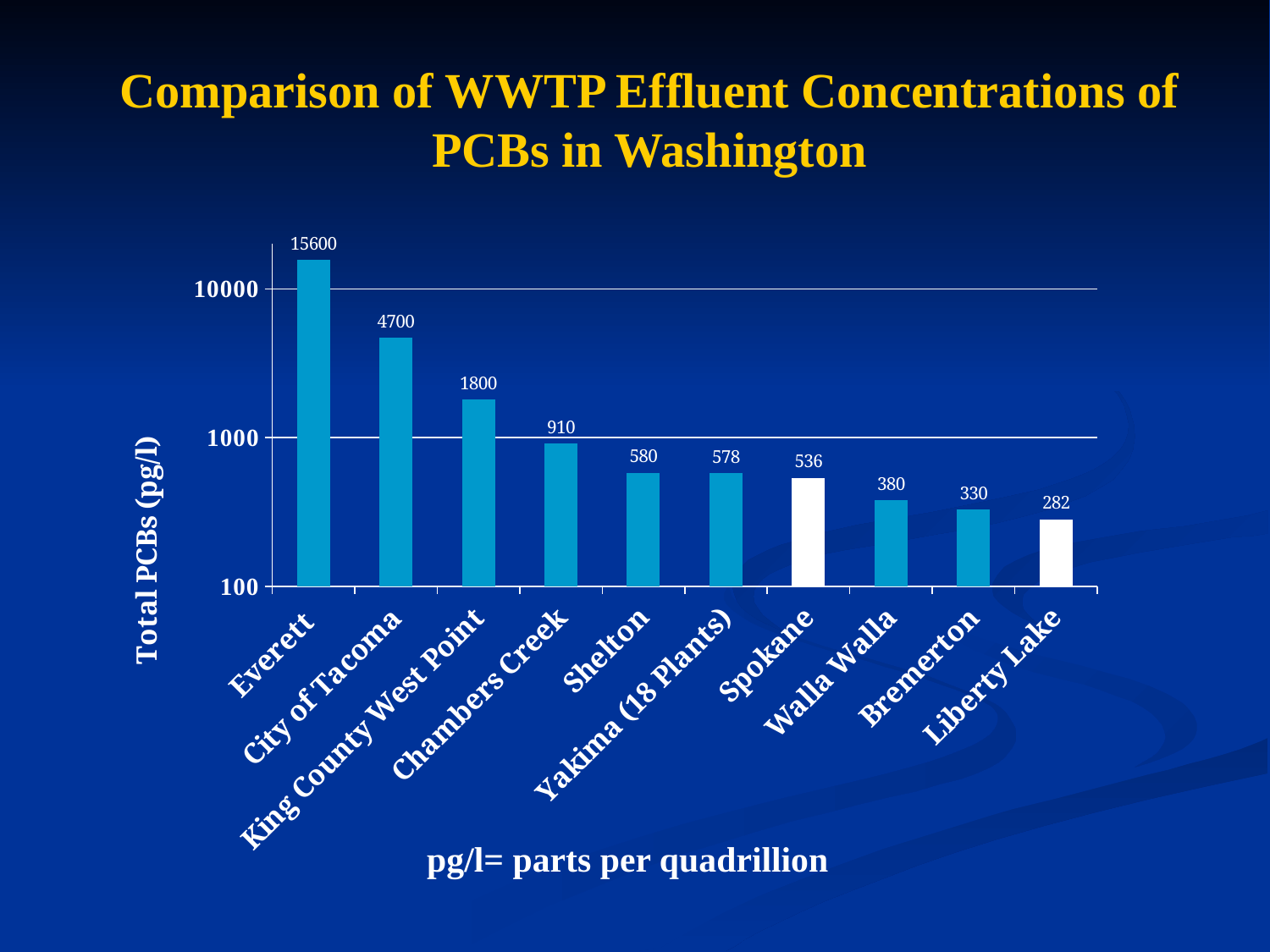
What kind of chart is shown on the slide? bar chart Which has a higher total PCB concentration, Chambers Creek or Shelton? Chambers Creek What is the total PCB concentration for Everett? 15600 What is the total PCB concentration for Liberty Lake? 282 What is the total PCB concentration for Spokane? 536 What is the difference between the values for City of Tacoma and King County West Point? 2900 How many plants are shown on the x axis? 10 Do the values rise or fall from left to right along the x axis? fall Which plant has the lowest total PCB concentration? Liberty Lake Is the value for Chambers Creek greater or less than 1000? less What is the difference between the values for Walla Walla and Bremerton? 50 Which plant has the highest total PCB concentration? Everett